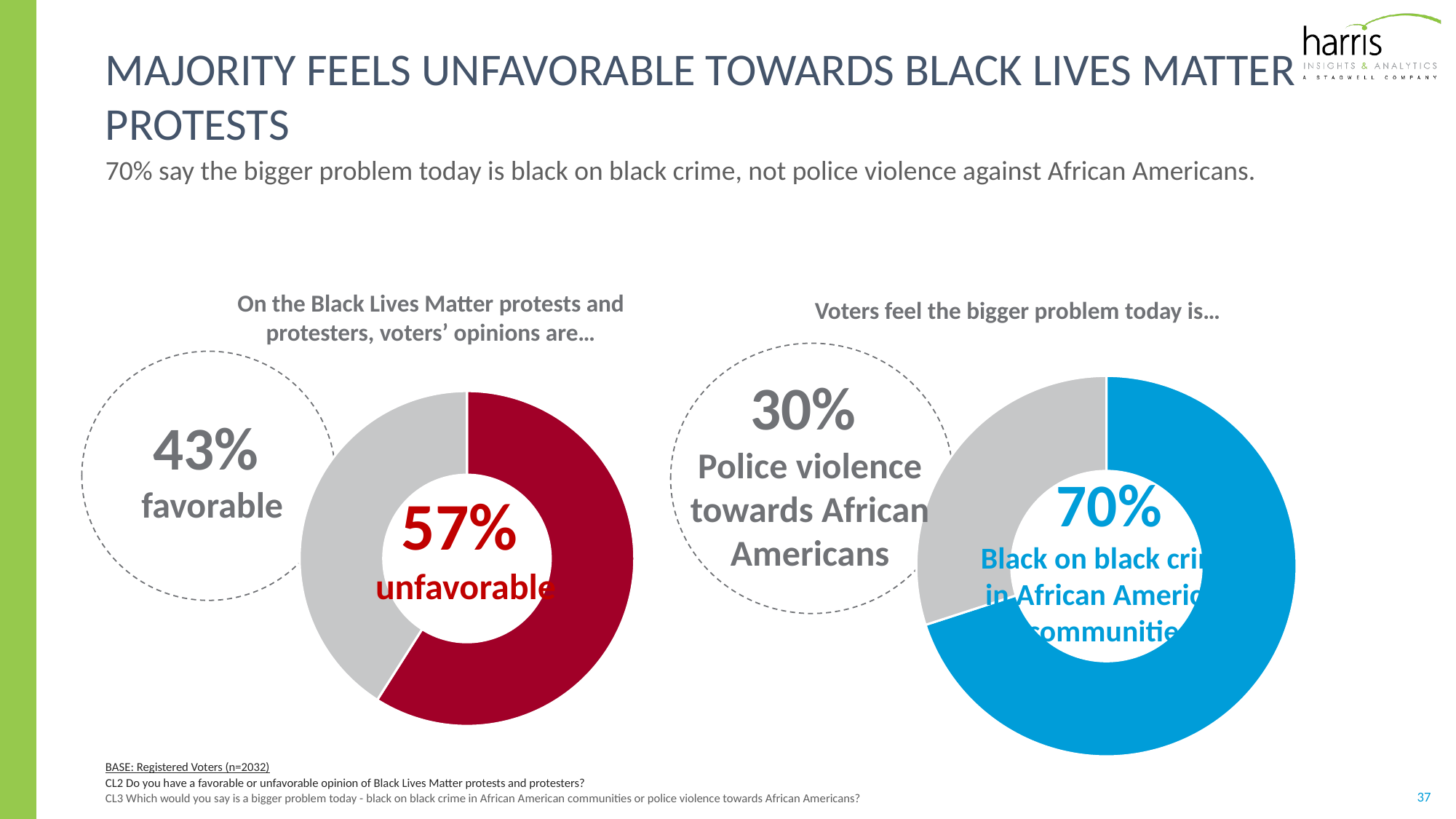
In the right chart on the bigger problem today, what colour is the slice for black on black crime? Blue In the right chart on the bigger problem today, what share of voters chose police violence towards African Americans? 30% In the left chart on Black Lives Matter protests, what share of voters are unfavorable? 57% What kind of chart is used on the left side of the slide? Donut (pie) chart How many slices does the right chart on the bigger problem today have? 2 In the left chart on Black Lives Matter protests, what colour is the unfavorable slice? Red In the right chart on the bigger problem today, what is the difference in percentage points between black on black crime and police violence? 40 In the left chart on Black Lives Matter protests, what share of voters are favorable? 43% In the right chart on the bigger problem today, what share of voters chose black on black crime in African American communities? 70% In the left chart on Black Lives Matter protests, what is the difference in percentage points between unfavorable and favorable? 14 In the right chart on the bigger problem today, which option has the smaller share? Police violence towards African Americans In the left chart on Black Lives Matter protests, which opinion has the larger share, favorable or unfavorable? unfavorable